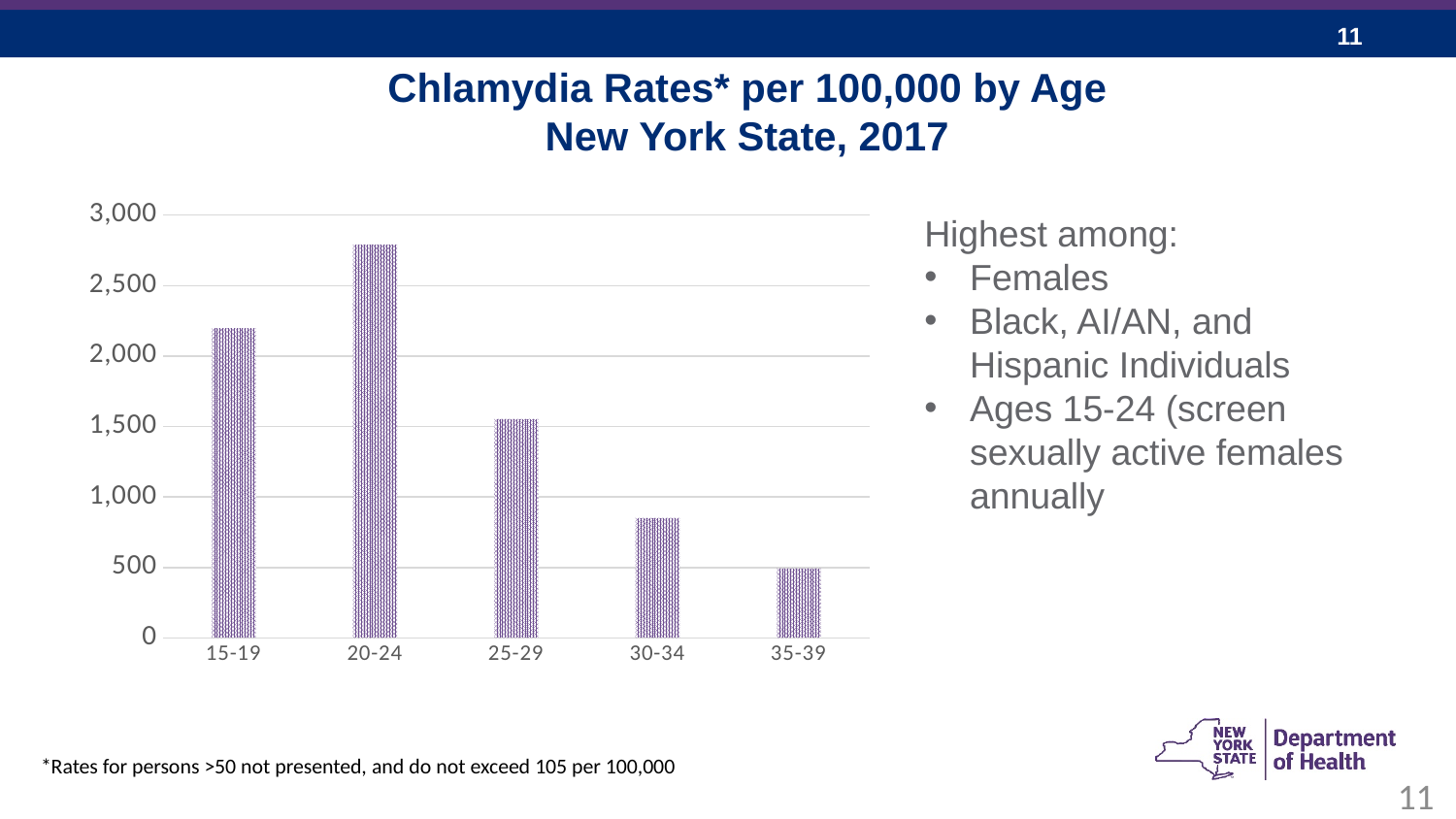
Which age group has a higher chlamydia rate, 30-34 or 35-39? 30-34 What kind of chart is shown on the slide? bar chart Which age group has the lowest chlamydia rate? 35-39 How many age groups are shown on the chart? 5 Is the value for 20-24 greater or less than 2,500? greater Which age group has the highest chlamydia rate? 20-24 Is the value for 35-39 greater or less than 1,000? less Is the value for 15-19 greater or less than 2,000? greater Which age group has a higher chlamydia rate, 15-19 or 25-29? 15-19 From the 20-24 age group to the 35-39 age group, do the chlamydia rates rise or fall? fall